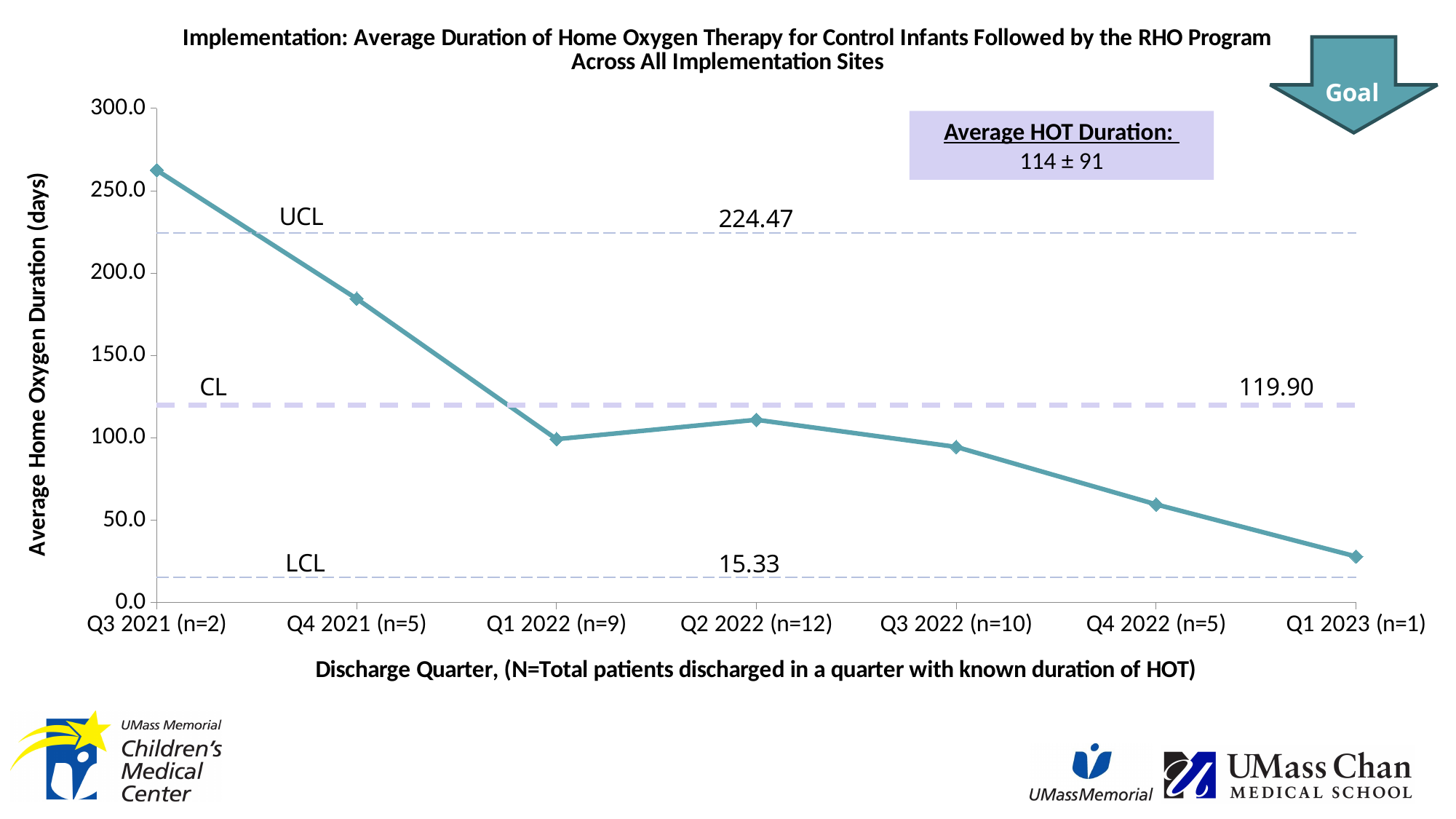
Which is larger, the value for Q4 2021 (n=5) or the value for Q2 2022 (n=12)? Q4 2021 (n=5) What is the value of the UCL line? 224.47 Which discharge quarter has the highest average home oxygen duration? Q3 2021 (n=2) Is the value for Q3 2021 (n=2) greater or less than 250? greater What is the value of the CL line? 119.90 What is the difference between the UCL and the LCL values? 209.14 What kind of chart is shown on the slide? line chart What is the value of the LCL line? 15.33 Which discharge quarter has the lowest average home oxygen duration? Q1 2023 (n=1) How many discharge quarters are plotted on the x axis? 7 What is the Average HOT Duration stated in the box on the chart? 114 ± 91 Is the value for Q4 2022 (n=5) greater or less than 100? less